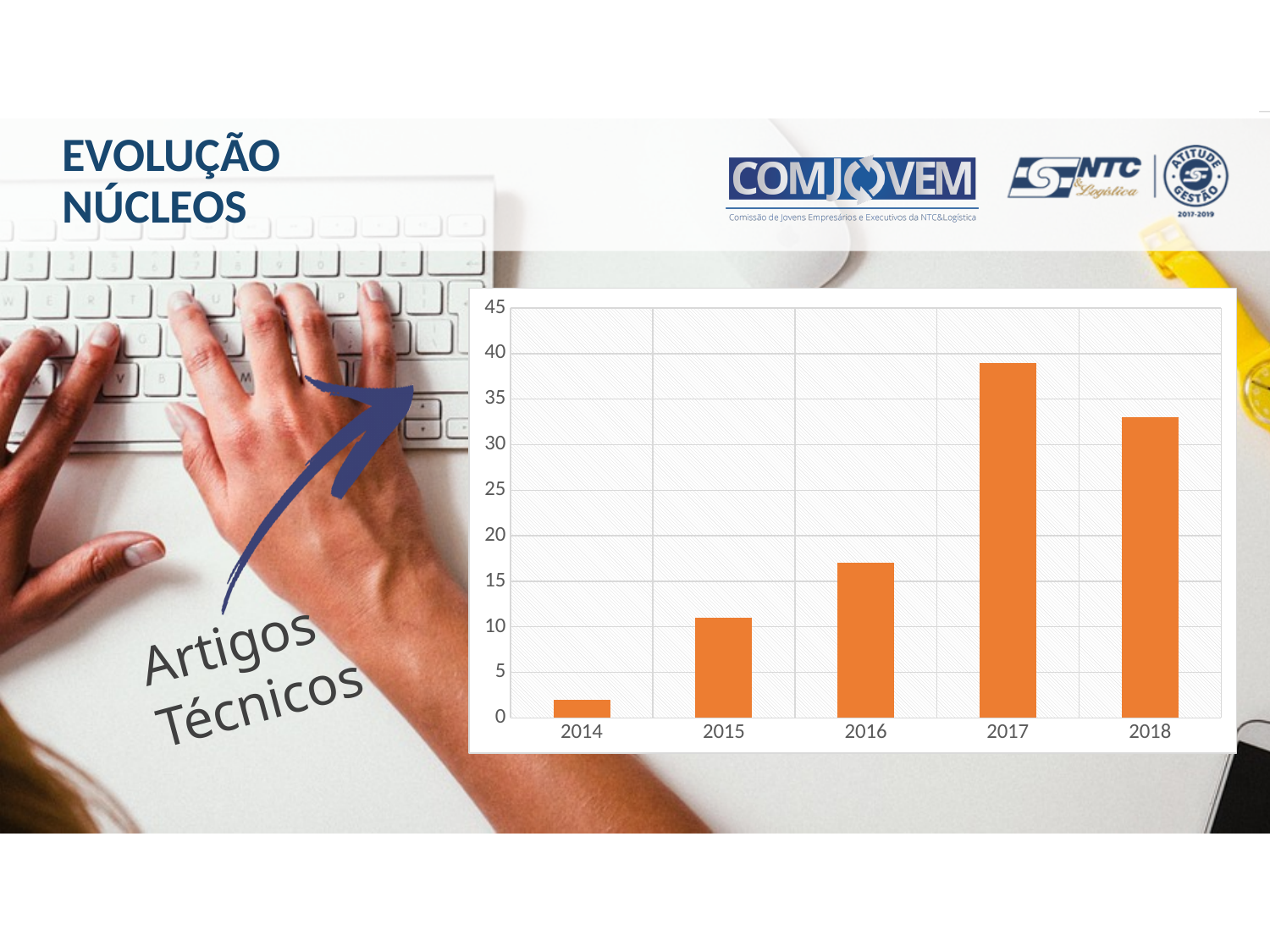
Is the value for 2015 greater or less than 15? less Which year has the highest bar in the chart? 2017 Is the value for 2016 greater or less than 15? greater Is the value for 2018 greater or less than 30? greater How many years are shown on the x axis of the chart? 5 What colour are the bars in the chart? orange What kind of chart is shown on the slide? bar chart Which year has the lowest bar in the chart? 2014 Which is larger, the value for 2015 or the value for 2016? 2016 Which is larger, the value for 2017 or the value for 2018? 2017